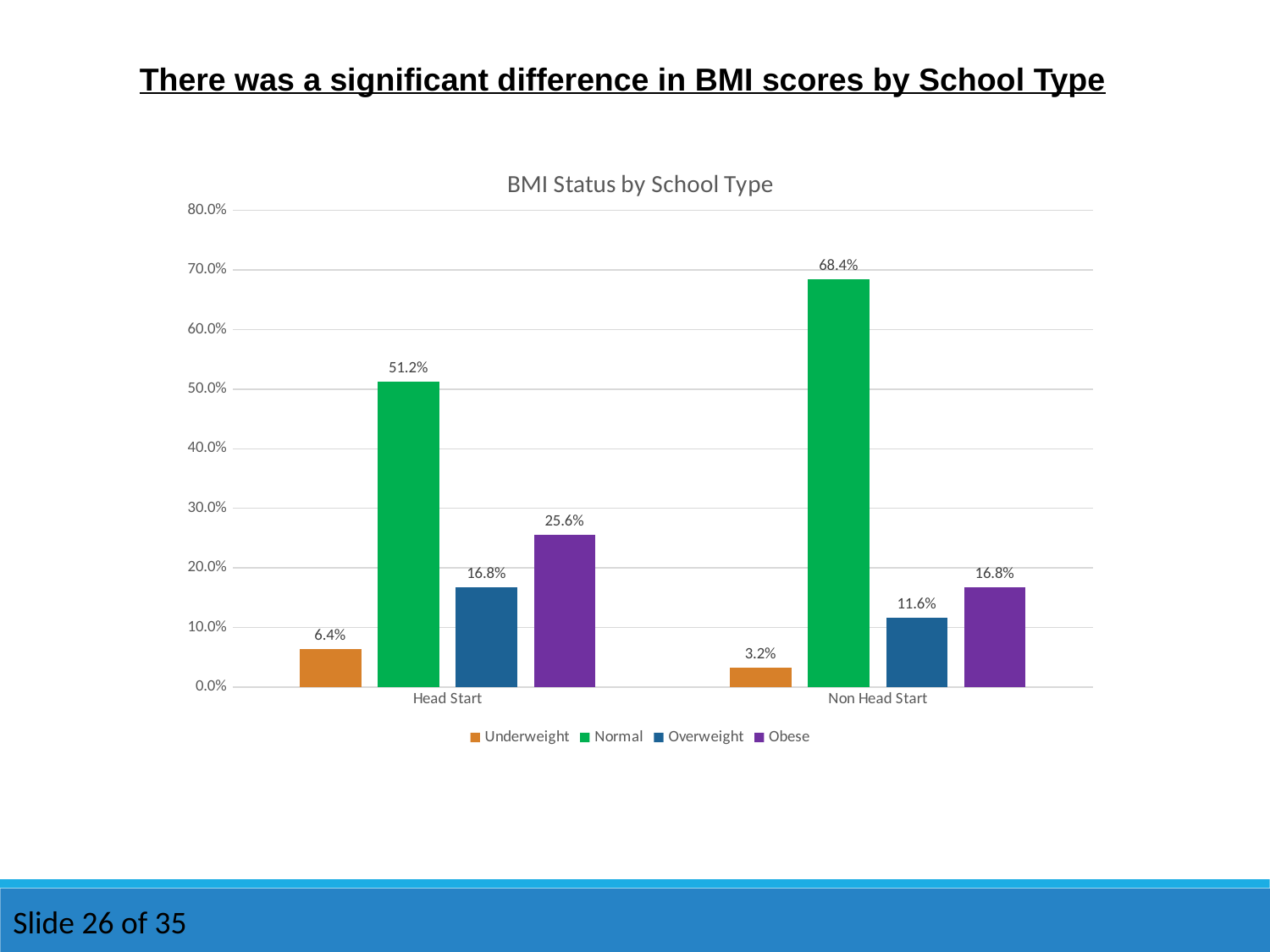
What kind of chart is shown? bar chart Which BMI category has the highest value for Non Head Start? Normal Which is larger, the Obese value for Head Start or the Obese value for Non Head Start? Head Start How many series does the legend list? 4 What is the Obese value for Non Head Start? 16.8% What is the Underweight value for Non Head Start? 3.2% Is the Overweight value for Non Head Start greater or less than 20.0%? less What is the Normal value for Head Start? 51.2% How many school types are shown on the x axis? 2 Which BMI category has the lowest value for Head Start? Underweight What is the title of the chart? BMI Status by School Type What is the difference between the Normal values for Non Head Start and Head Start? 17.2%